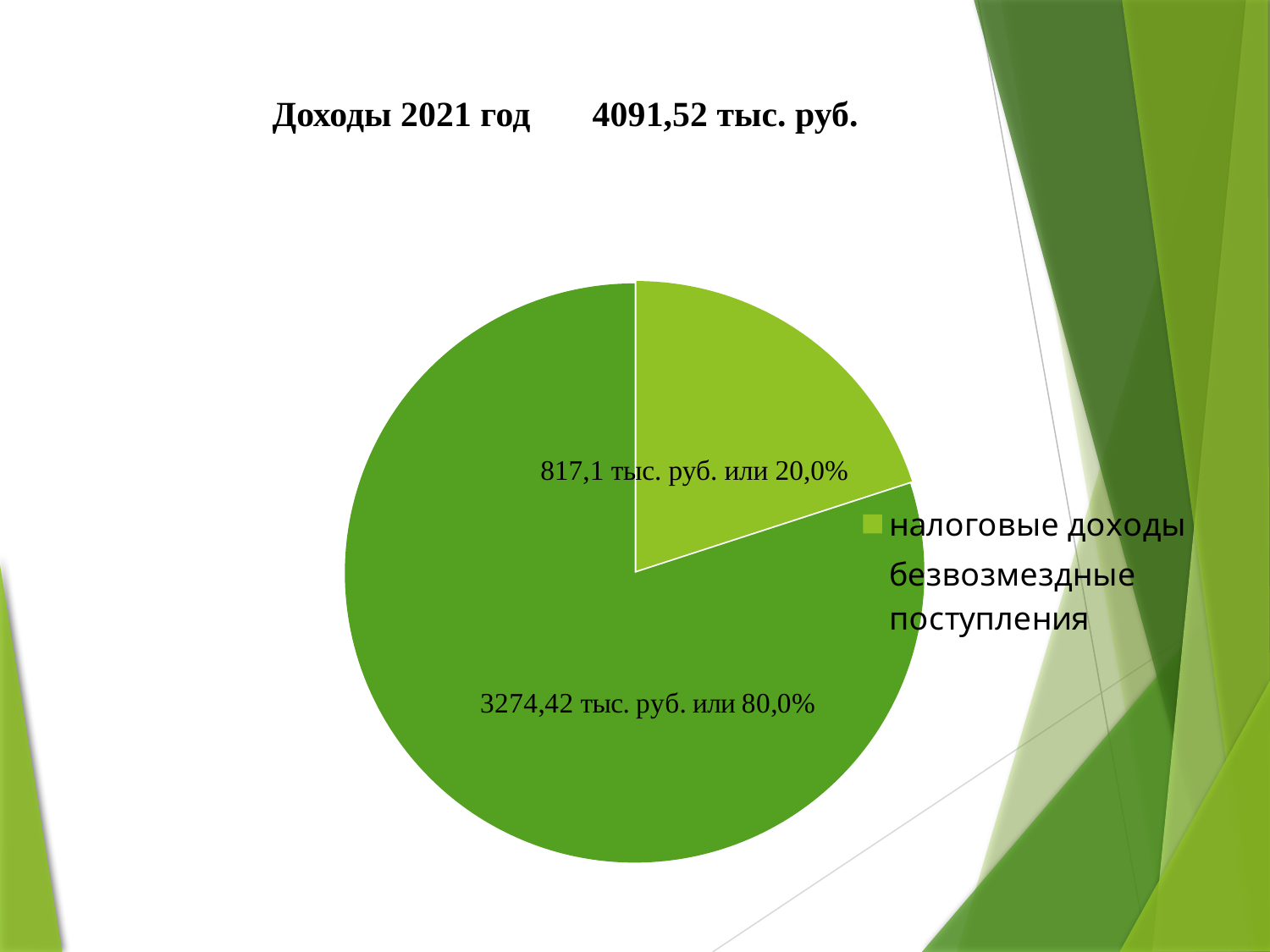
What share of the pie does налоговые доходы represent? 20,0% How many slices does the pie chart have? 2 What kind of chart is shown on the slide? pie chart What value is shown for безвозмездные поступления in the pie chart? 3274,42 тыс. руб. What is the difference between безвозмездные поступления and налоговые доходы in тыс. руб.? 2457,32 тыс. руб. Which is larger, налоговые доходы or безвозмездные поступления? безвозмездные поступления Which slice of the pie chart is the largest? безвозмездные поступления Which slice of the pie chart is the smallest? налоговые доходы What value is shown for налоговые доходы in the pie chart? 817,1 тыс. руб. What share of the pie does безвозмездные поступления represent? 80,0% How many entries does the legend of the pie chart list? 2 What total income for 2021 is stated in the slide title? 4091,52 тыс. руб.